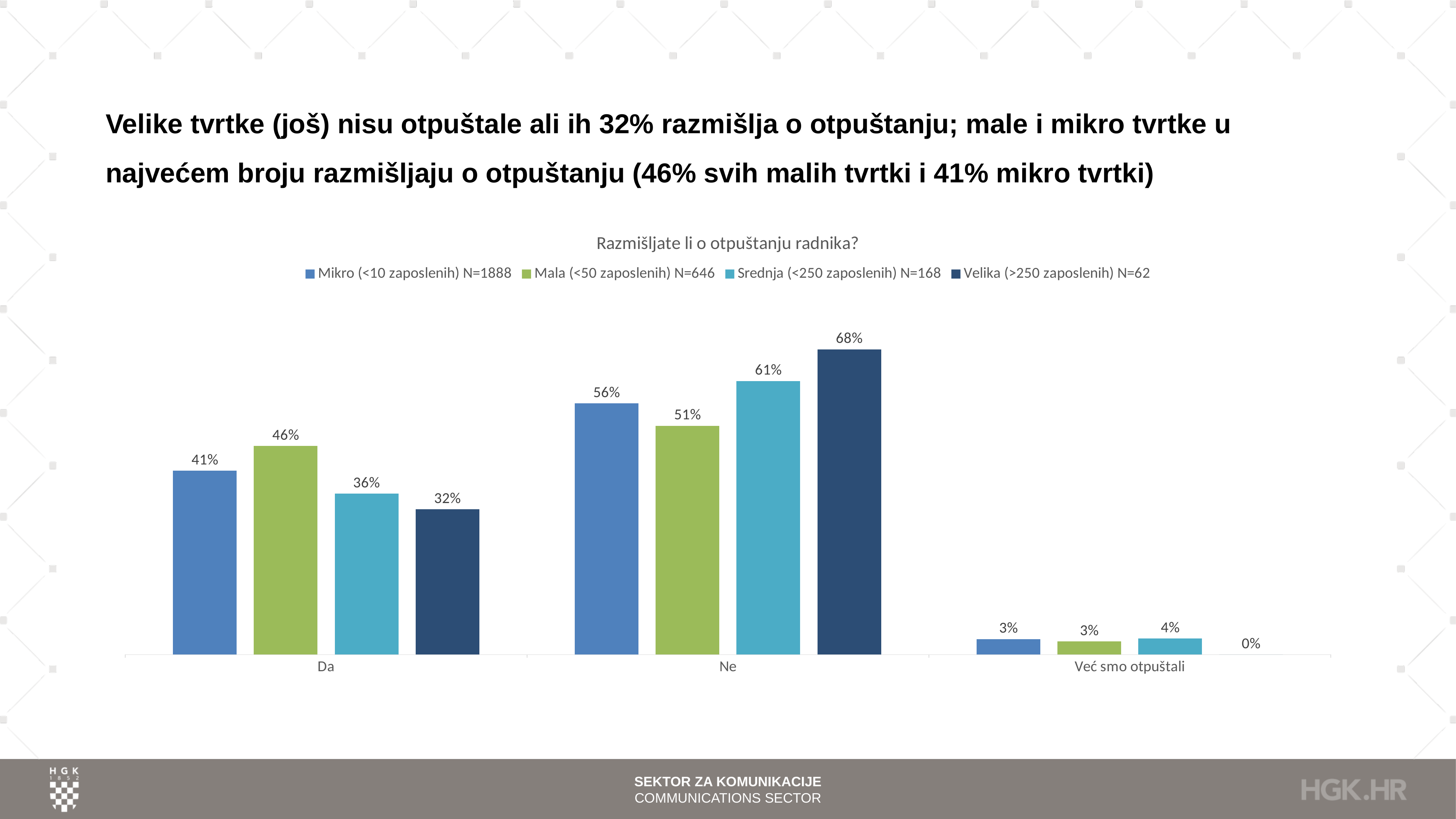
How many series does the legend list? 4 What is the sample size (N) for the Mikro series in the legend? N=1888 What is the value for Srednja (<250 zaposlenih) in the "Već smo otpuštali" category? 4% What is the value for Mikro (<10 zaposlenih) in the "Da" category? 41% Which series has the highest value in the "Da" category? Mala (<50 zaposlenih) N=646 What is the value for Velika (>250 zaposlenih) in the "Ne" category? 68% What is the title of the chart? Razmišljate li o otpuštanju radnika? What is the difference between the Velika and Mikro values in the "Ne" category? 12% Which is larger: the Mala value for "Da" or the Srednja value for "Da"? Mala (<50 zaposlenih) N=646 Which series has the lowest value in the "Već smo otpuštali" category? Velika (>250 zaposlenih) N=62 What kind of chart is shown on the slide? Bar chart How many categories are shown on the x axis? 3